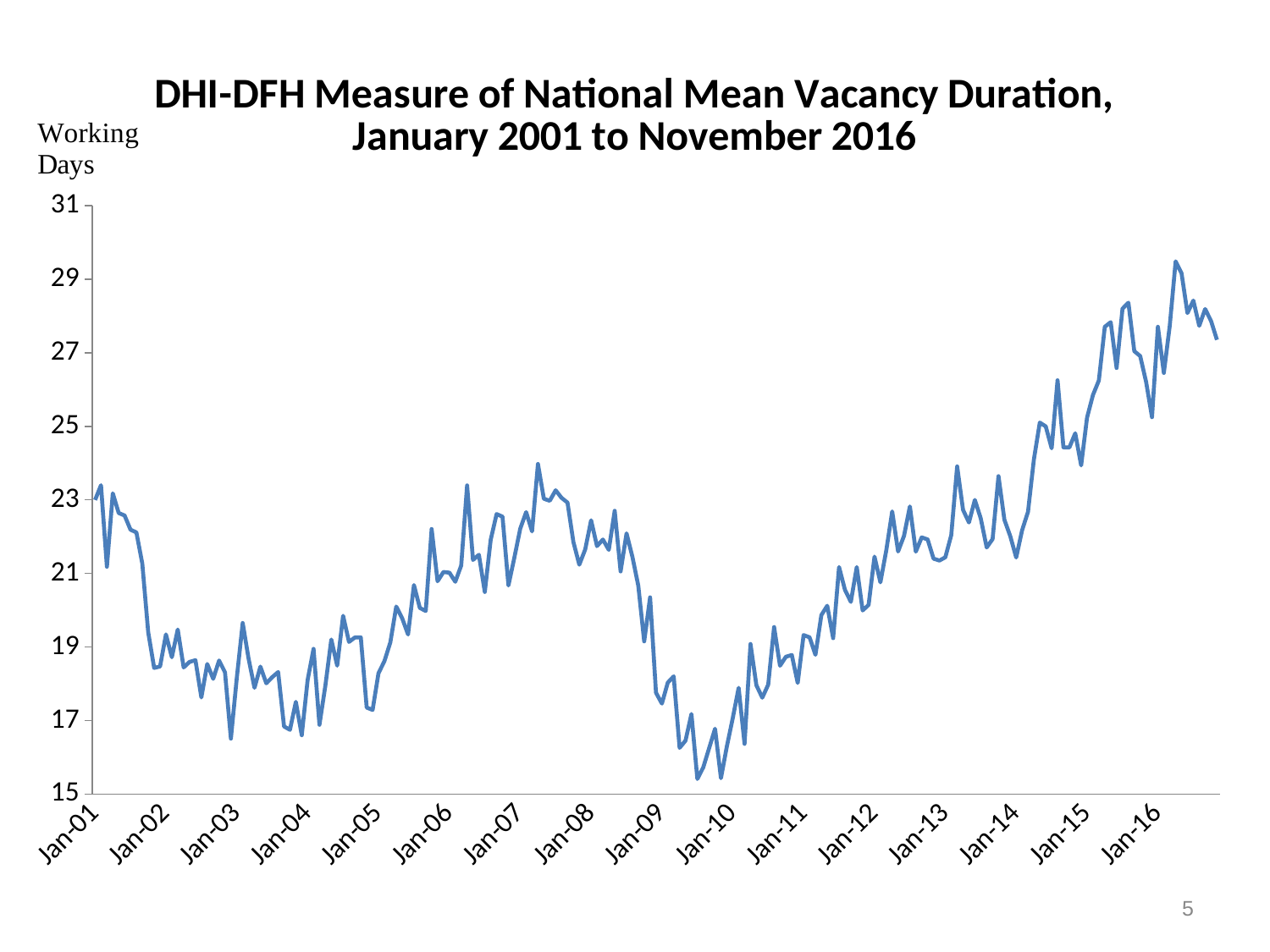
Does the series rise or fall between Jan-10 and Jan-16? rise What kind of chart is shown on the slide? line chart What unit is the vertical axis labelled in? Working Days Is the value at Jan-03 greater or less than 21? less Does the series rise or fall between Jan-08 and Jan-10? fall Is the value at Jan-16 greater or less than 25? greater Between which two horizontal-axis labels does the series reach its highest point? after Jan-16 (between Jan-16 and the end of the series) Is the value at Jan-01 greater or less than 21? greater Which is larger, the value at Jan-01 or the value at Jan-10? Jan-01 How many labelled tick marks are on the horizontal axis? 16 What is the title of the chart? DHI-DFH Measure of National Mean Vacancy Duration, January 2001 to November 2016